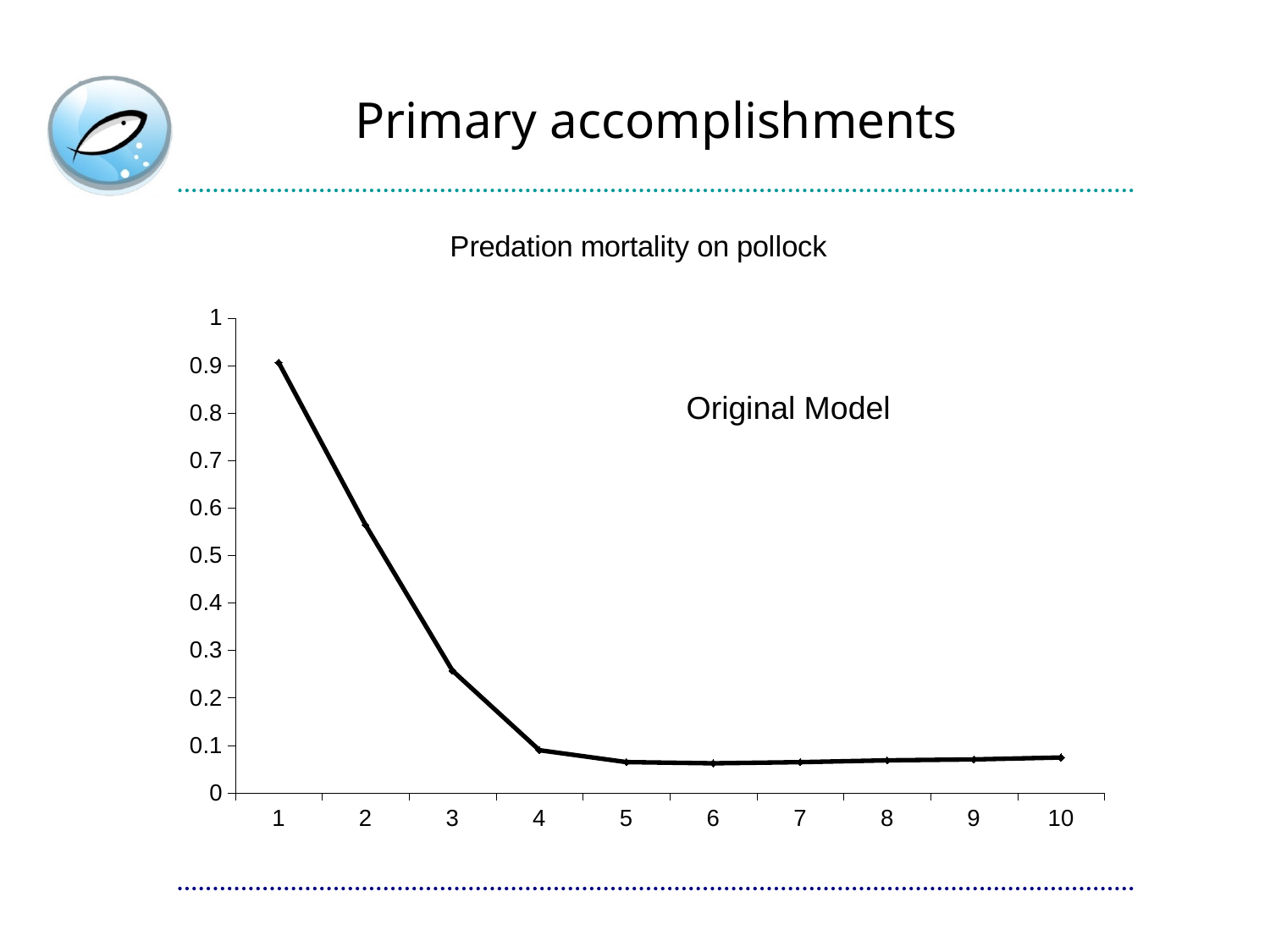
Does the predation mortality generally rise or fall from x = 1 to x = 5? fall Which has the larger value, x = 3 or x = 8? 3 Is the value at x = 4 greater or less than 0.2? less At which x-axis value is the predation mortality highest? 1 Which has the larger value, x = 1 or x = 2? 1 Is the value at x = 10 greater or less than 0.1? less Is the value at x = 1 greater or less than 0.8? greater What is the title of the chart? Predation mortality on pollock How many data points are plotted on the line? 10 What kind of chart is shown on the slide? line chart